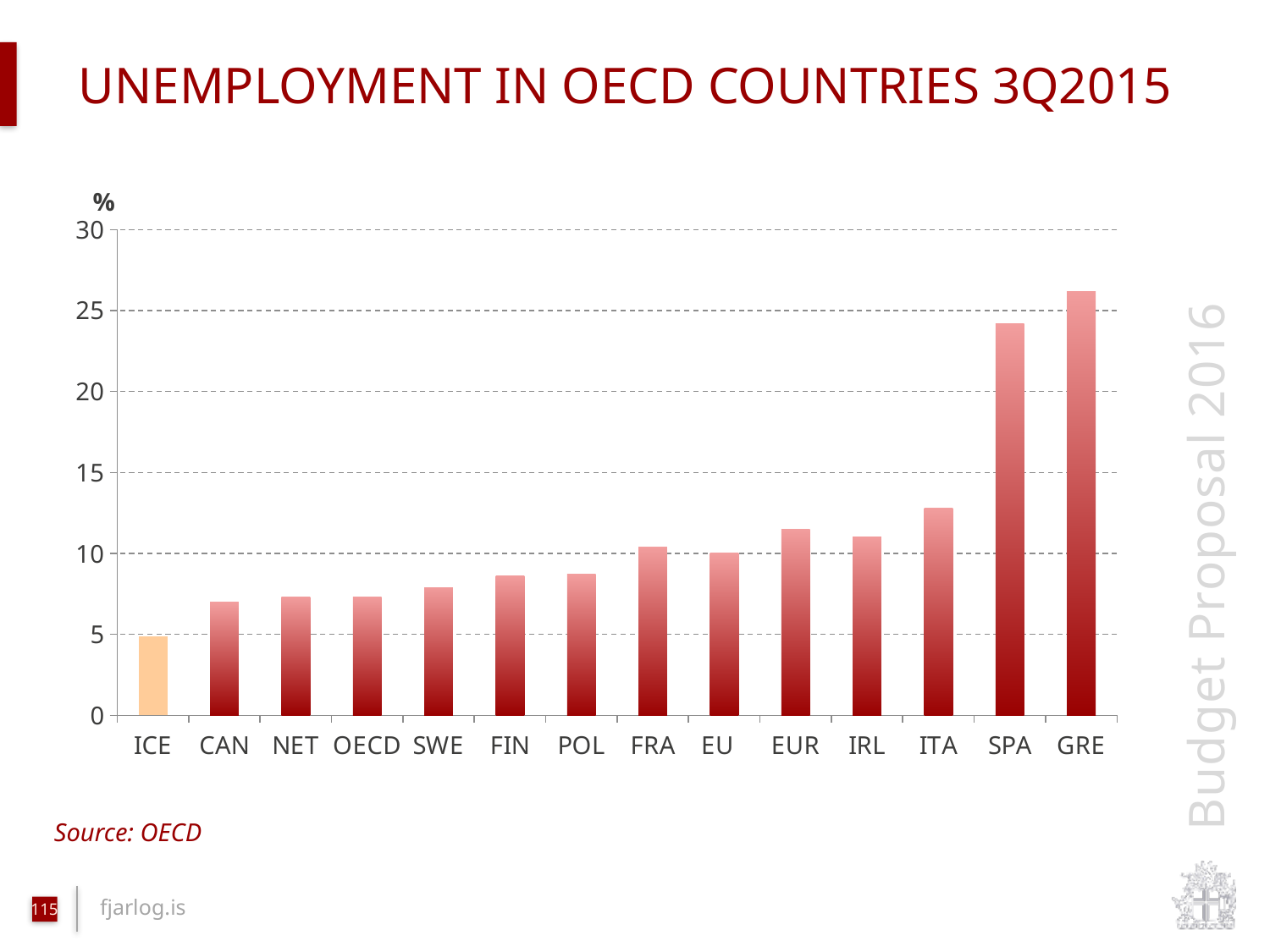
Which bar in the chart is shown in a different colour from the others? ICE Which country has the highest unemployment rate in the chart? GRE Which country has the lowest unemployment rate in the chart? ICE How many countries or regions are shown on the x axis of the chart? 14 Is the value for CAN greater or less than 5? greater Which has a higher unemployment rate, ICE or CAN? CAN What kind of chart is shown on the slide? bar chart Is the value for SPA greater or less than 25? less Is the value for SWE greater or less than 10? less Which has a higher unemployment rate, ITA or IRL? ITA